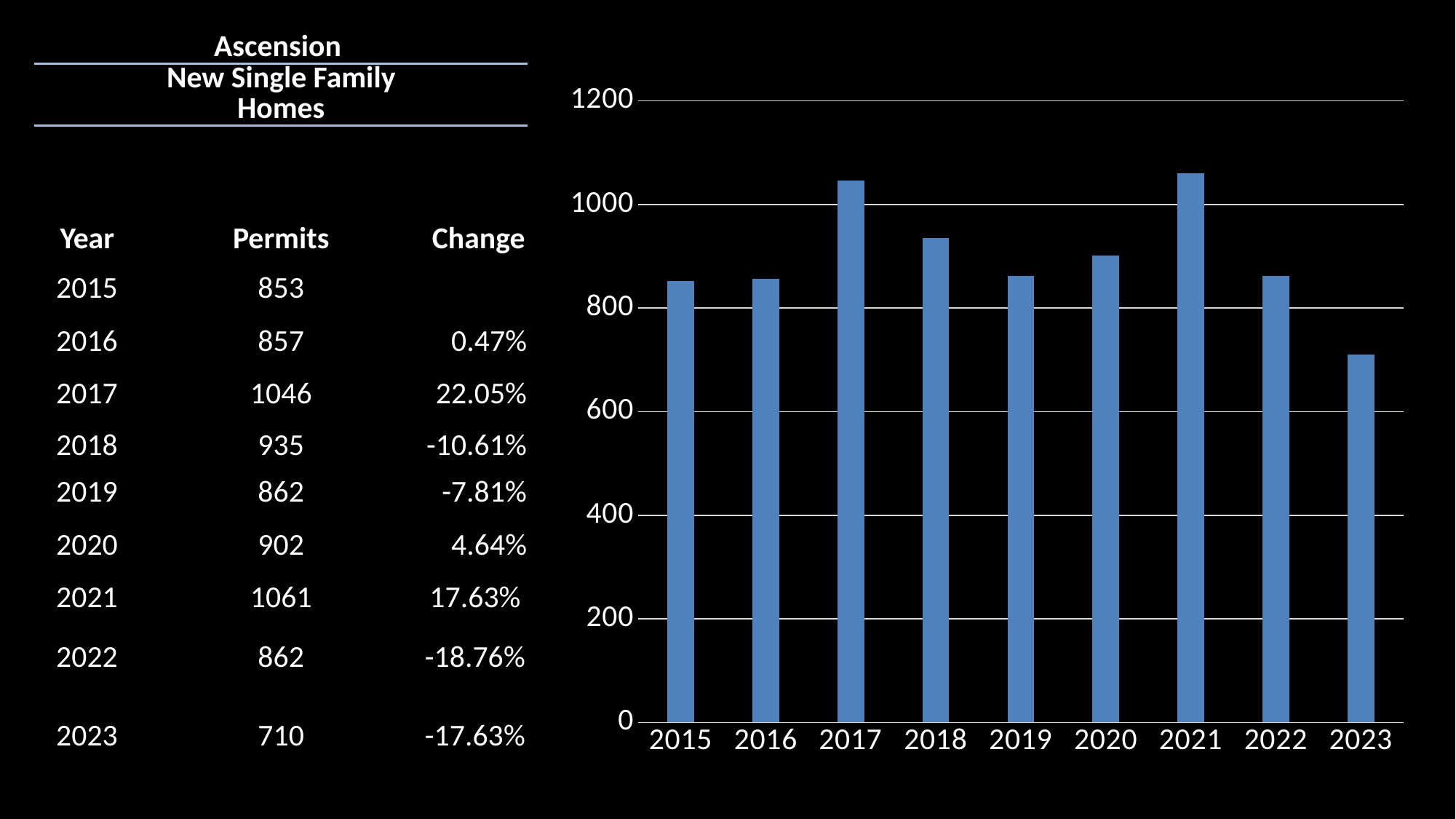
What is the percentage change shown for 2022? -18.76% Is the value for 2023 greater or less than 800? less How many years are plotted on the bar chart? 9 Which is larger, the number of permits in 2017 or in 2021? 2021 How many permits were issued in 2023? 710 How many permits were issued in 2017? 1046 Which year has the lowest number of permits? 2023 What type of chart is shown on the slide? bar chart What is the difference in permits between 2021 and 2023? 351 What is the title of the table on the slide? Ascension New Single Family Homes Is the value for 2018 greater or less than 800? greater Which year has the highest number of permits? 2021